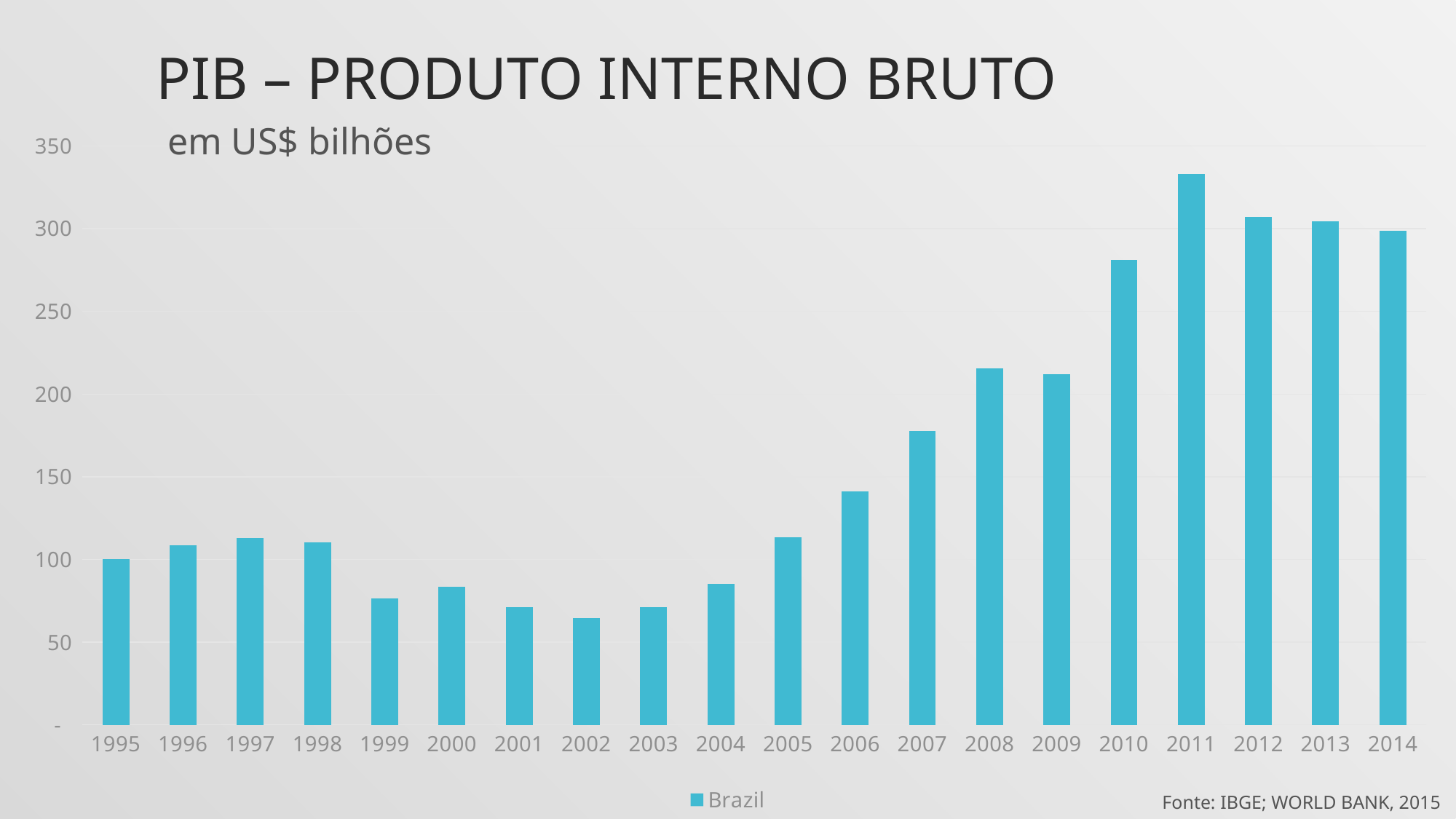
What kind of chart is shown on the slide? bar chart What series name is shown in the legend? Brazil Which year has the lowest value? 2002 How many years are plotted on the x axis? 20 Is the value for 2011 greater or less than 300? greater Which is larger, the value for 2005 or the value for 2004? 2005 Is the value for 2010 greater or less than 250? greater How many series does the legend list? 1 Do the values rise or fall from 2002 to 2008? rise Which year has the highest value? 2011 Is the value for 2002 greater or less than 100? less